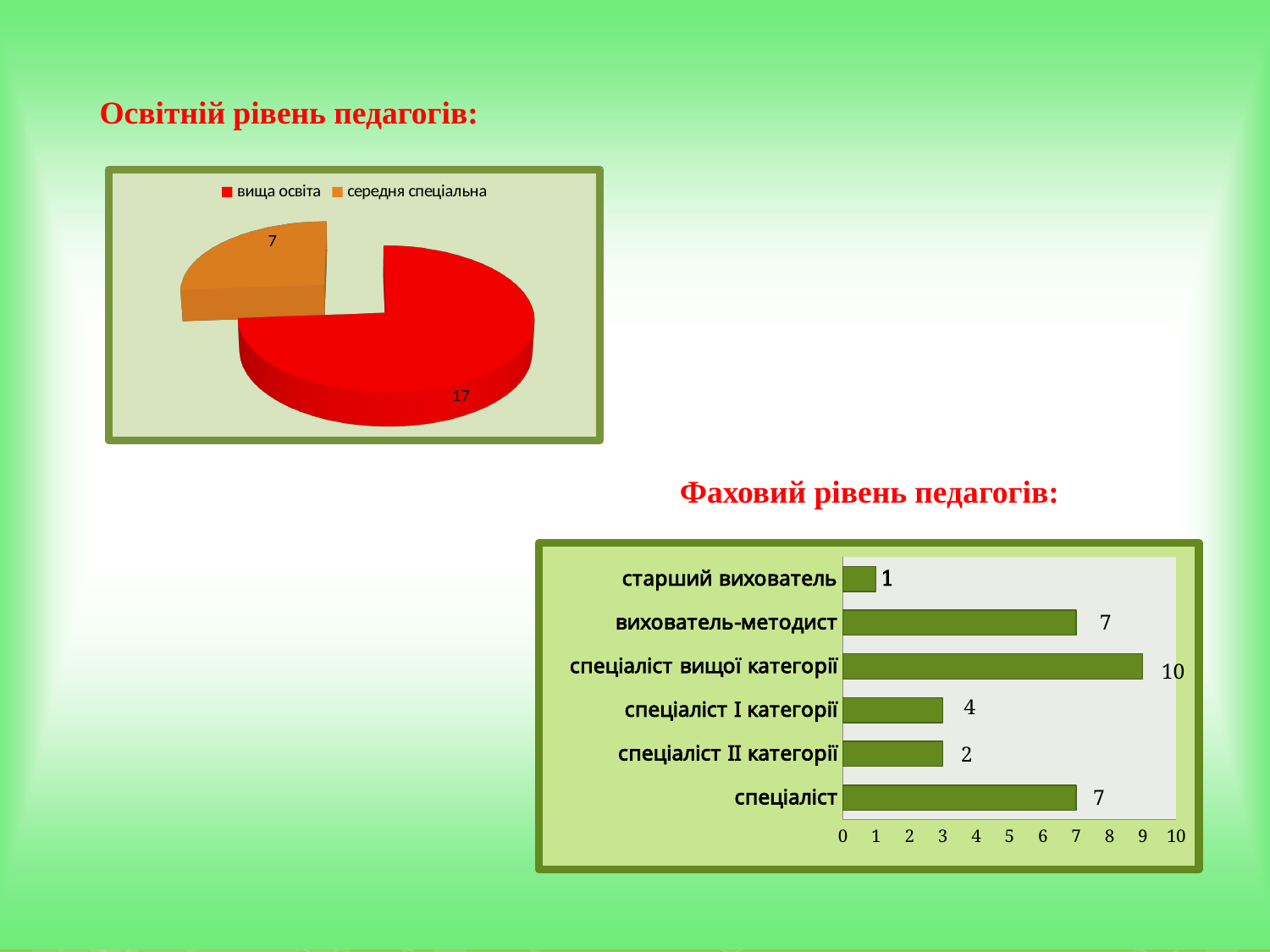
In the pie chart titled "Освітній рівень педагогів:", what is the difference between the values for "вища освіта" and "середня спеціальна"? 10 In the pie chart titled "Освітній рівень педагогів:", what is the value for "вища освіта"? 17 What kind of chart is shown under the title "Фаховий рівень педагогів:"? Bar chart In the pie chart titled "Освітній рівень педагогів:", what is the value for "середня спеціальна"? 7 In the bar chart titled "Фаховий рівень педагогів:", what is the difference between the values for "вихователь-методист" and "спеціаліст I категорії"? 3 In the bar chart titled "Фаховий рівень педагогів:", which category has the lowest value? старший вихователь In the bar chart titled "Фаховий рівень педагогів:", what is the value for "спеціаліст II категорії"? 2 In the pie chart titled "Освітній рівень педагогів:", what colour is the slice for "середня спеціальна"? Orange In the bar chart titled "Фаховий рівень педагогів:", what is the value for "спеціаліст вищої категорії"? 10 In the pie chart titled "Освітній рівень педагогів:", how many entries does the legend list? 2 In the pie chart titled "Освітній рівень педагогів:", which category has the larger slice? вища освіта In the bar chart titled "Фаховий рівень педагогів:", how many categories are shown? 6